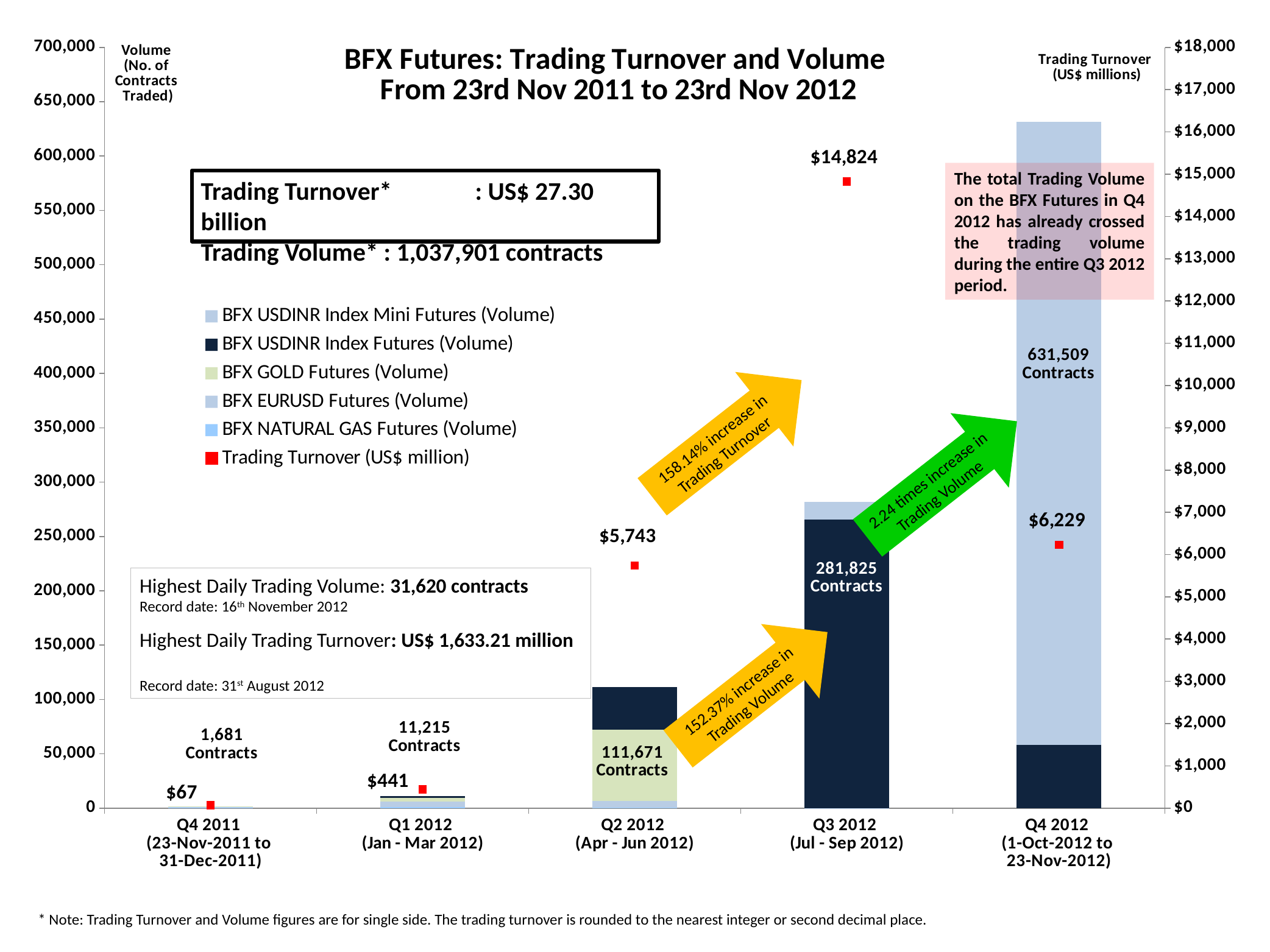
Which quarter has the highest Trading Turnover? Q3 2012 (Jul - Sep 2012) Does the trading volume rise or fall from Q4 2011 to Q4 2012? rise What is the Trading Turnover value shown for Q3 2012 (Jul - Sep 2012)? $14,824 What is the Trading Turnover value shown for Q1 2012 (Jan - Mar 2012)? $441 Which quarter has the lowest Trading Turnover? Q4 2011 (23-Nov-2011 to 31-Dec-2011) Which quarter has the highest trading volume (tallest bar)? Q4 2012 (1-Oct-2012 to 23-Nov-2012) What is the difference in contracts traded between Q4 2012 and Q3 2012? 349,684 Which has the larger Trading Turnover, Q3 2012 or Q4 2012? Q3 2012 How many series does the legend list? 6 What is the difference in Trading Turnover between Q3 2012 and Q2 2012? $9,081 How many contracts were traded in Q4 2012 (1-Oct-2012 to 23-Nov-2012) according to the bar label? 631,509 Contracts How many quarters are shown on the x axis? 5